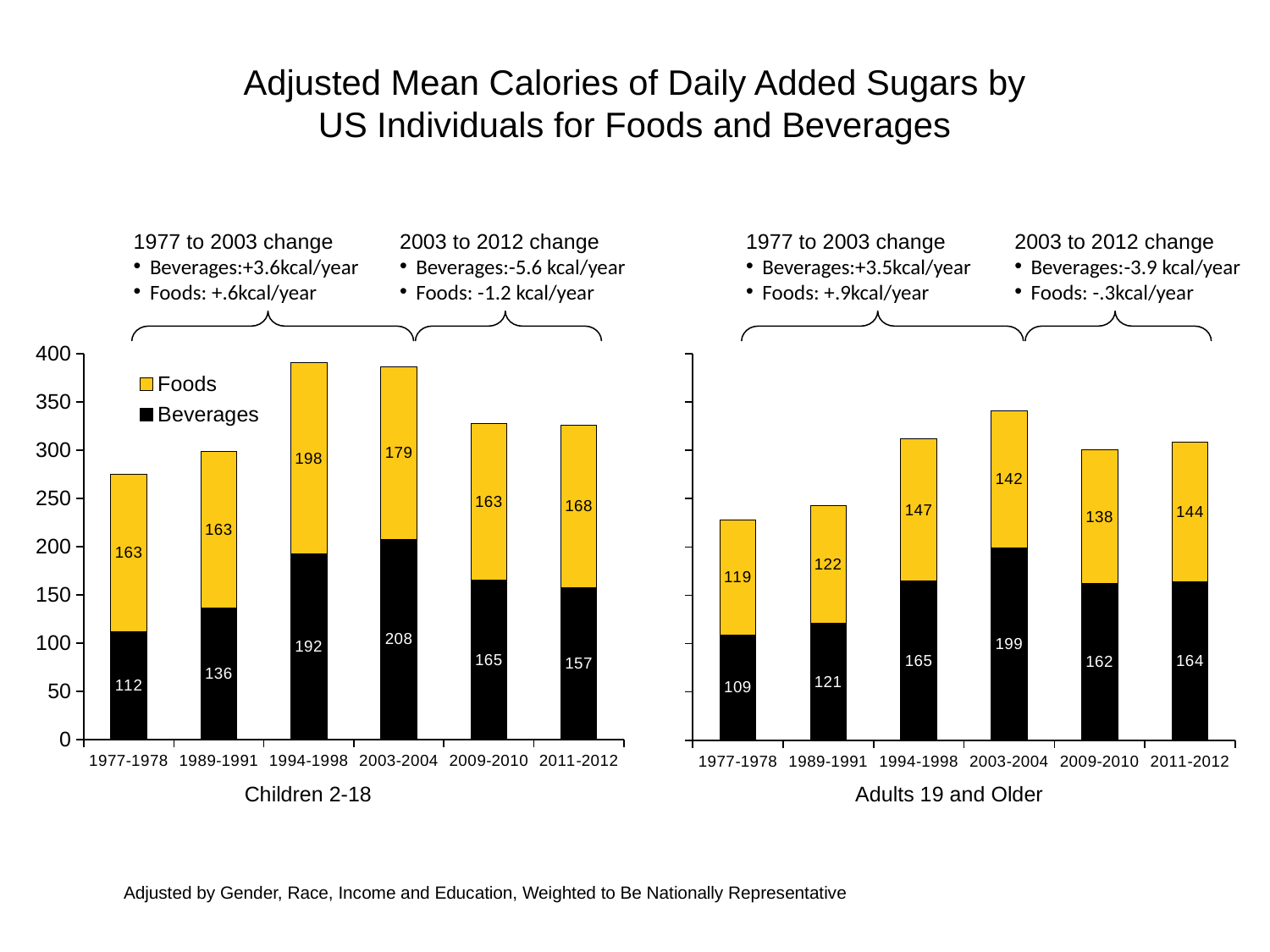
In the Adults 19 and Older chart, which period has the lowest Beverages value? 1977-1978 In the Adults 19 and Older chart, which is larger: the Beverages value for 2009-2010 or for 2011-2012? 2011-2012 In the Children 2-18 chart, what is the Beverages value for 2003-2004? 208 In the Adults 19 and Older chart, what is the total of the stacked bar for 2003-2004? 341 In the Children 2-18 chart, which colour represents Foods? Yellow In the Children 2-18 chart, which period has the highest Beverages value? 2003-2004 What kind of chart is the Adults 19 and Older chart? Stacked bar chart How many time periods are shown on the x axis of the Children 2-18 chart? 6 In the Children 2-18 chart, what is the difference between the Foods values for 1994-1998 and 2003-2004? 19 How many series does the legend of the Children 2-18 chart list? 2 In the Children 2-18 chart, what is the total of the stacked bar for 1977-1978? 275 In the Adults 19 and Older chart, what is the Foods value for 1994-1998? 147